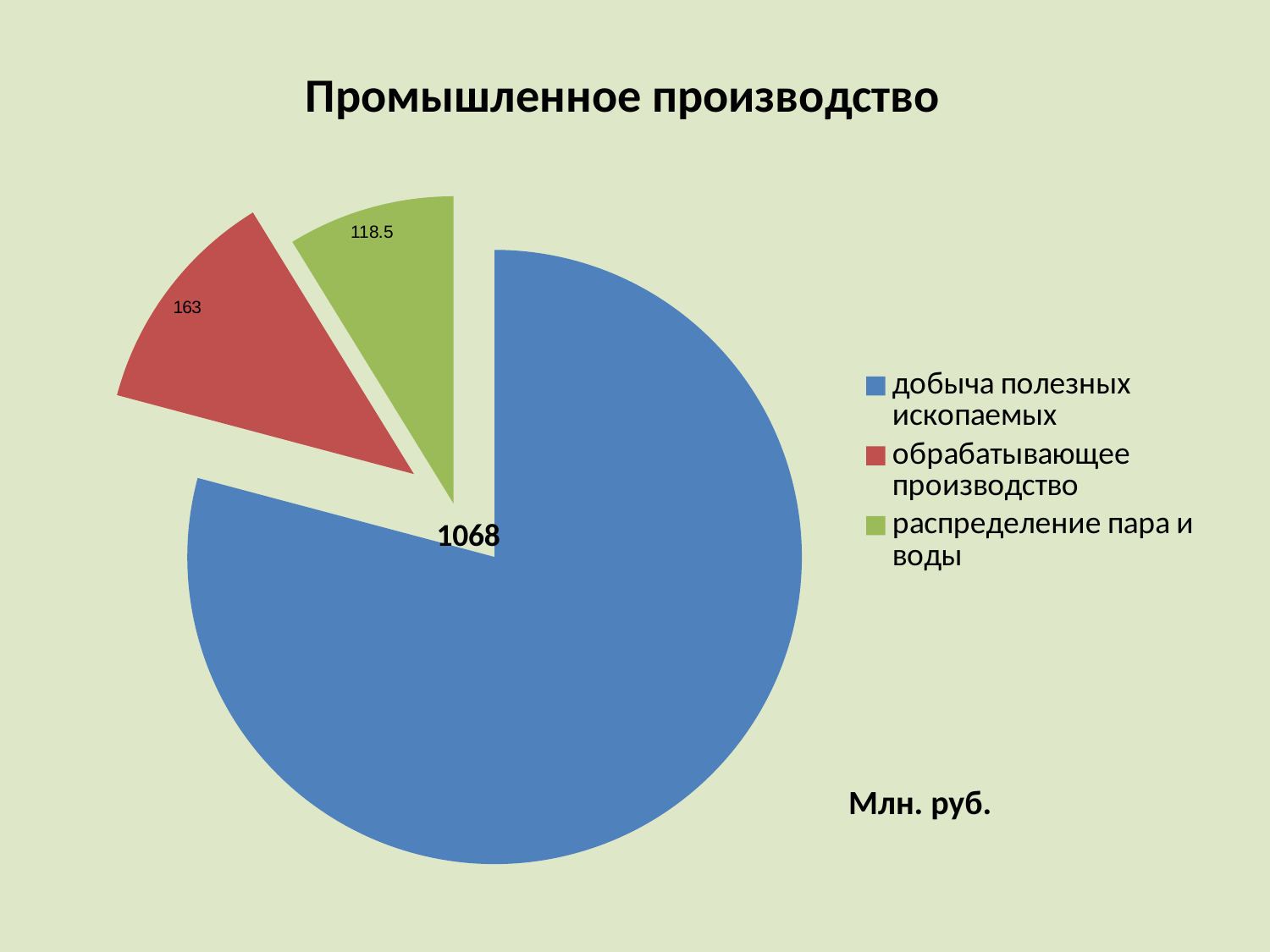
What is the value for распределение пара и воды? 118.5 Which category has the largest slice of the pie? добыча полезных ископаемых Which is larger, the value for обрабатывающее производство or the value for распределение пара и воды? обрабатывающее производство What unit is indicated for the values on the slide? Млн. руб. How many categories are shown in the pie chart? 3 What is the value for добыча полезных ископаемых? 1068 What is the value for обрабатывающее производство? 163 What is the difference between the values for добыча полезных ископаемых and обрабатывающее производство? 905 What is the title of the chart? Промышленное производство What is the difference between the values for обрабатывающее производство and распределение пара и воды? 44.5 Which category has the smallest slice of the pie? распределение пара и воды What type of chart is shown on the slide? pie chart